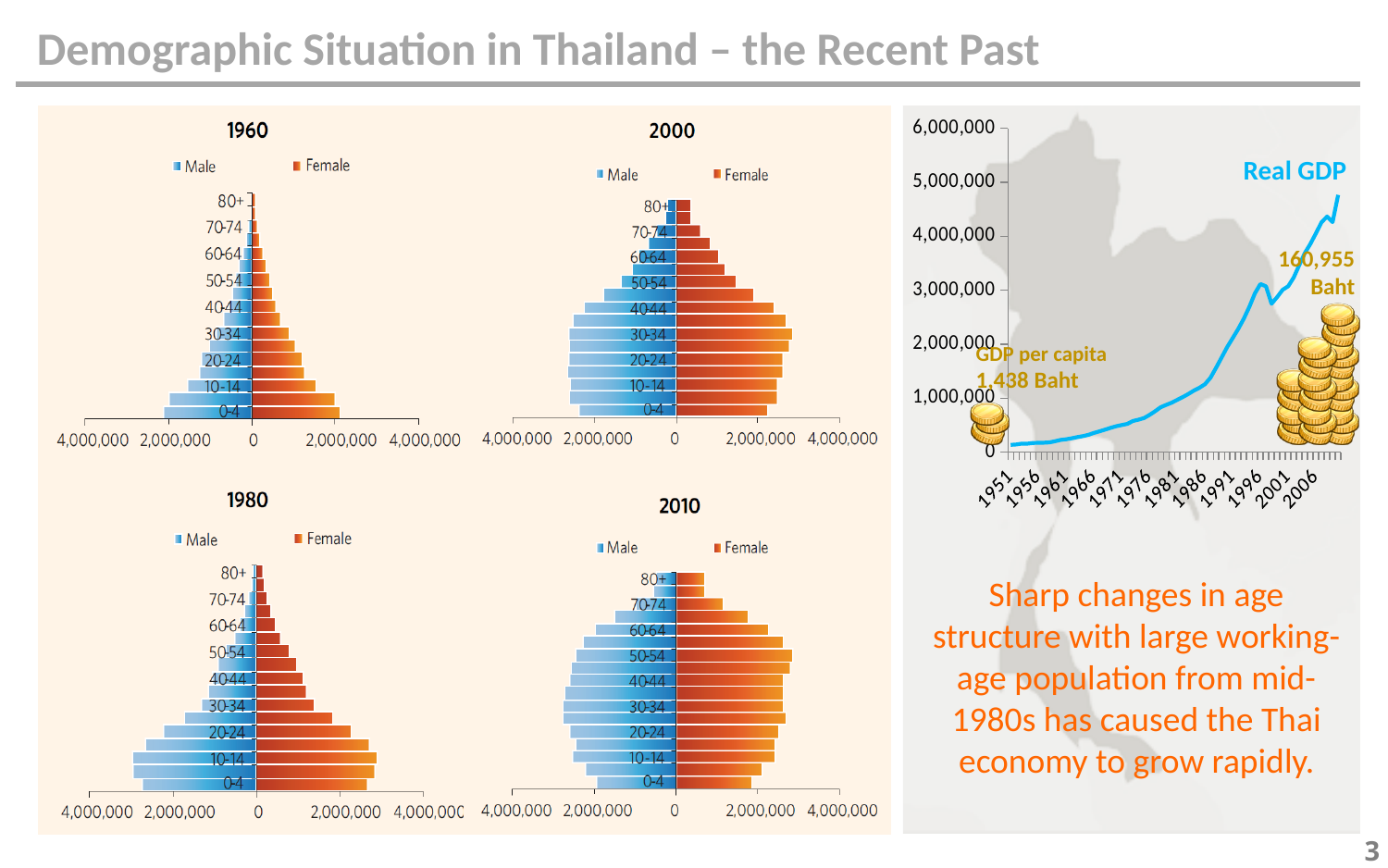
How many series does the legend of the 2000 chart list? 2 In the 2010 chart, is the Female value for 50-54 greater or less than 2,000,000? greater In the 2000 chart, which age group has the longest Female bar? 30-34 What type of chart is the 1960 chart? bar chart In the 1960 chart, which is larger, the Female value for 0-4 or the Female value for 60-64? 0-4 In the 1980 chart, which age group has the longest bars? 10-14 In the 1960 chart, is the Female value for 60-64 greater or less than 2,000,000? less In the Real GDP chart, what GDP per capita value is labelled at the end of the line? 160,955 Baht In the 1980 chart, is the Female value for 10-14 greater or less than 2,000,000? greater What type of chart is the Real GDP chart on the right? line chart In the Real GDP chart, does the line rise or fall from 1951 to 2006? rise In the 1960 chart, which age group has the longest bars? 0-4